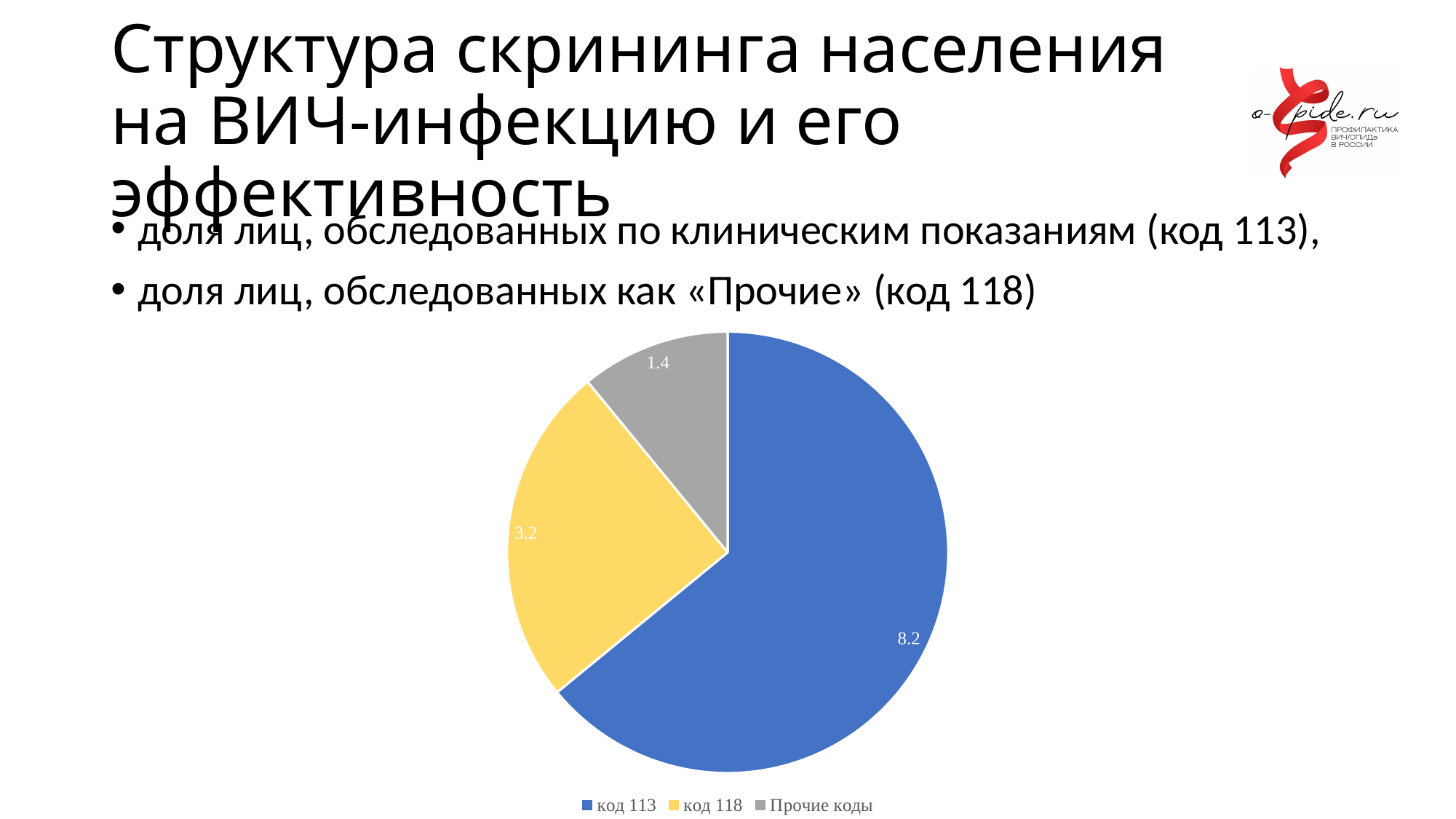
What is the value shown for the код 118 slice of the pie chart? 3.2 Which is larger, the value for код 118 or the value for Прочие коды? код 118 Which category has the largest slice in the pie chart? код 113 How many entries does the legend of the chart list? 3 What is the value shown for the Прочие коды slice of the pie chart? 1.4 How many slices does the pie chart have? 3 What is the total of all the values shown in the pie chart? 12.8 What type of chart is shown on the slide? Pie chart What colour is the код 118 slice in the pie chart? Yellow What is the difference between the values for код 113 and код 118? 5.0 Which category has the smallest slice in the pie chart? Прочие коды What is the value shown for the код 113 slice of the pie chart? 8.2